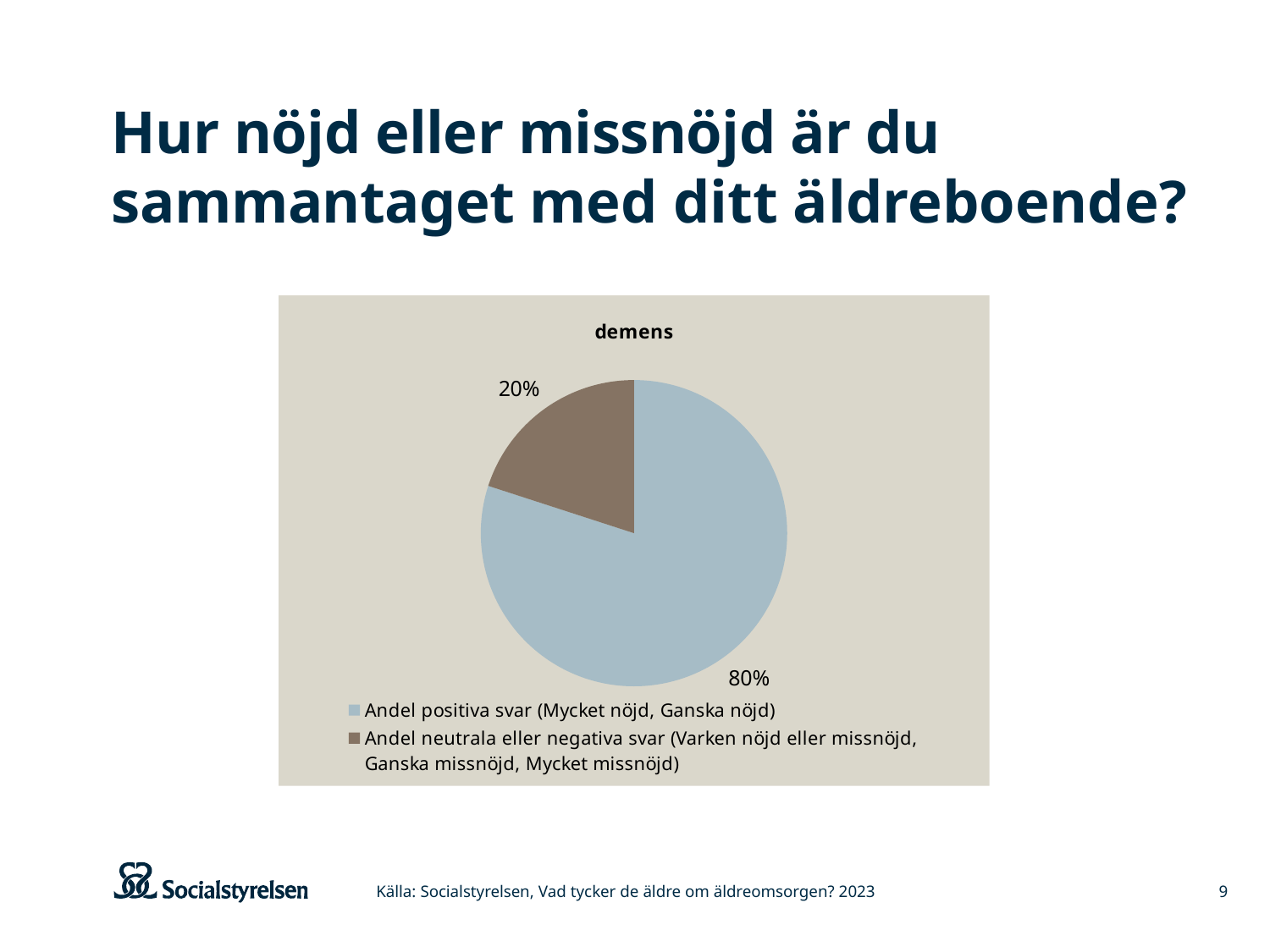
What is the difference between the positive share and the neutral or negative share? 60% How many slices does the pie chart have? 2 What is the chart's title? demens Which slice is the largest? Andel positiva svar (Mycket nöjd, Ganska nöjd) What share of the pie is 'Andel positiva svar (Mycket nöjd, Ganska nöjd)'? 80% How many entries does the legend list? 2 Which slice is the smallest? Andel neutrala eller negativa svar (Varken nöjd eller missnöjd, Ganska missnöjd, Mycket missnöjd) Which is larger: the share of positive answers or the share of neutral or negative answers? Andel positiva svar (Mycket nöjd, Ganska nöjd) What colour is the slice for 'Andel positiva svar (Mycket nöjd, Ganska nöjd)'? light blue What kind of chart is shown on the slide? pie chart What share of the pie is 'Andel neutrala eller negativa svar (Varken nöjd eller missnöjd, Ganska missnöjd, Mycket missnöjd)'? 20%